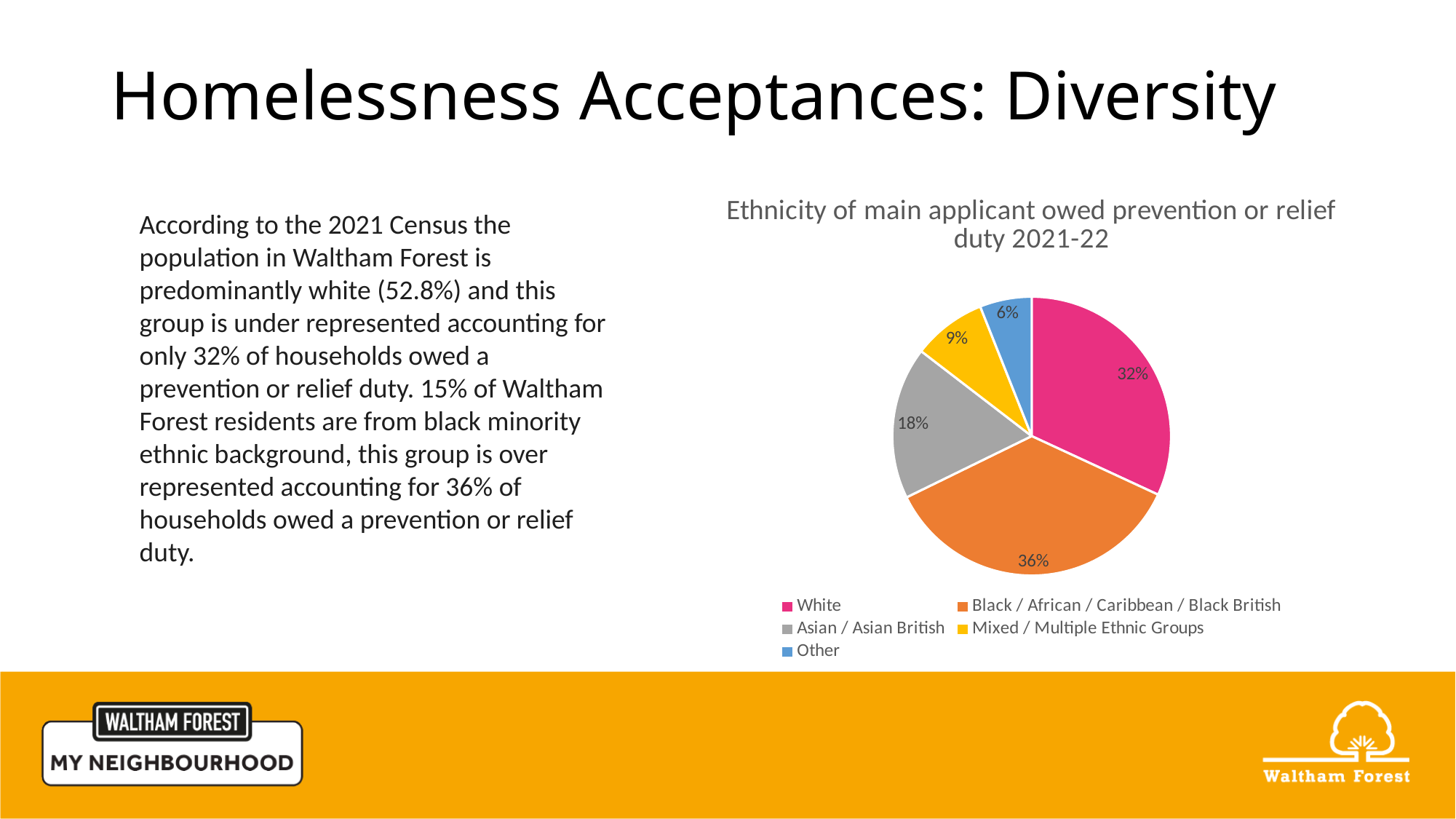
What is the title of the chart? Ethnicity of main applicant owed prevention or relief duty 2021-22 Which ethnic group has the smallest slice of the pie? Other How many categories does the legend list? 5 What kind of chart is shown on the slide? Pie chart What is the difference in percentage points between the Black / African / Caribbean / Black British slice and the White slice? 4 What share of the pie is Mixed / Multiple Ethnic Groups? 9% What share of the pie is Other? 6% Which ethnic group has the largest slice of the pie? Black / African / Caribbean / Black British What share of the pie is Asian / Asian British? 18% Which is larger, the Asian / Asian British slice or the Mixed / Multiple Ethnic Groups slice? Asian / Asian British